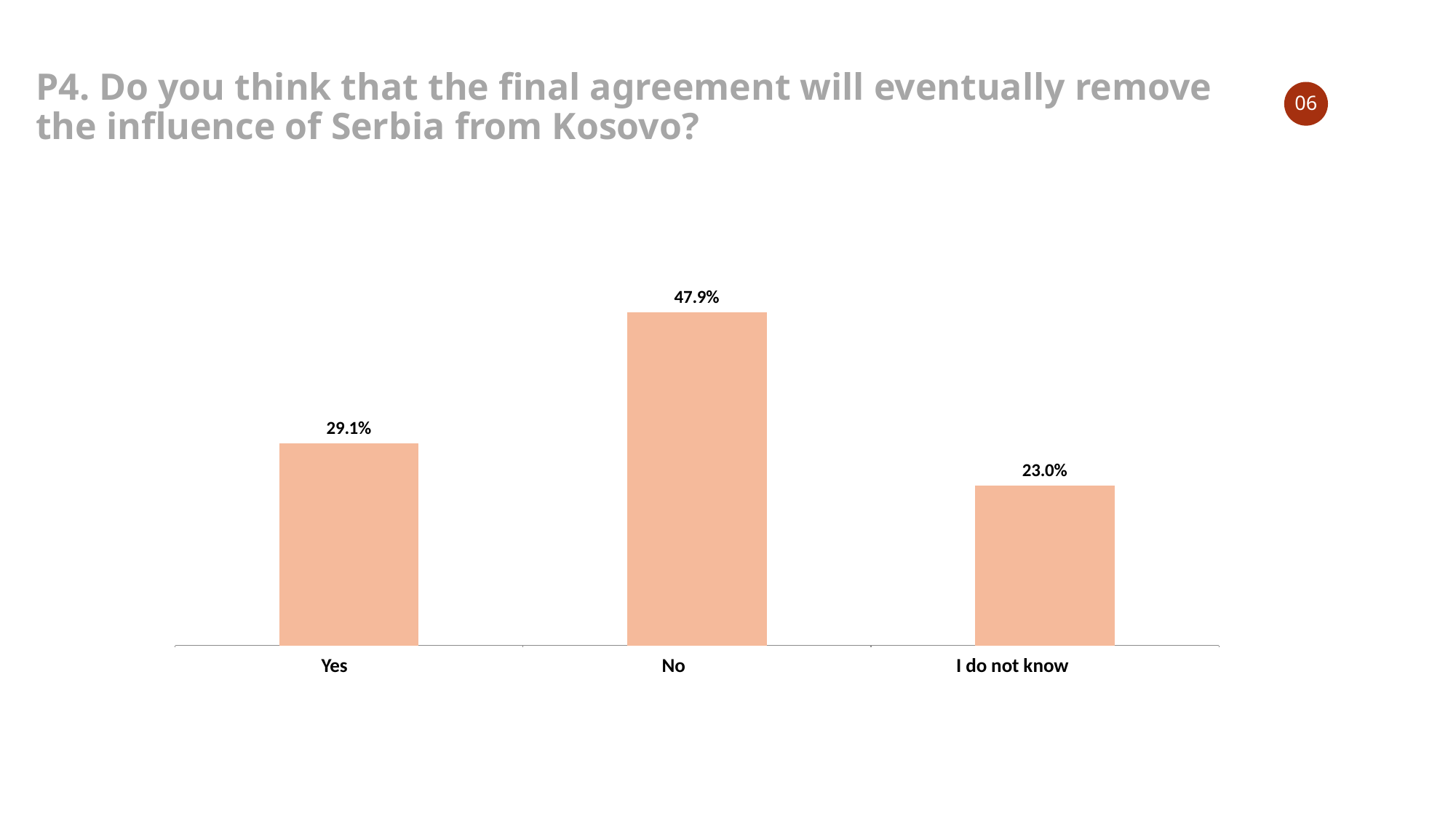
Which is larger, the value for "Yes" or the value for "I do not know"? Yes What percentage of respondents answered "I do not know"? 23.0% What percentage of respondents answered "No"? 47.9% Which response category has the lowest value? I do not know What is the difference in percentage points between "No" and "Yes"? 18.8 What question number is shown in the slide title? P4 What is the total of the three percentages shown in the chart? 100.0% What is the difference in percentage points between "Yes" and "I do not know"? 6.1 What percentage of respondents answered "Yes"? 29.1% Which response category has the highest value? No What kind of chart is shown on the slide? Bar chart How many response categories are shown in the chart? 3